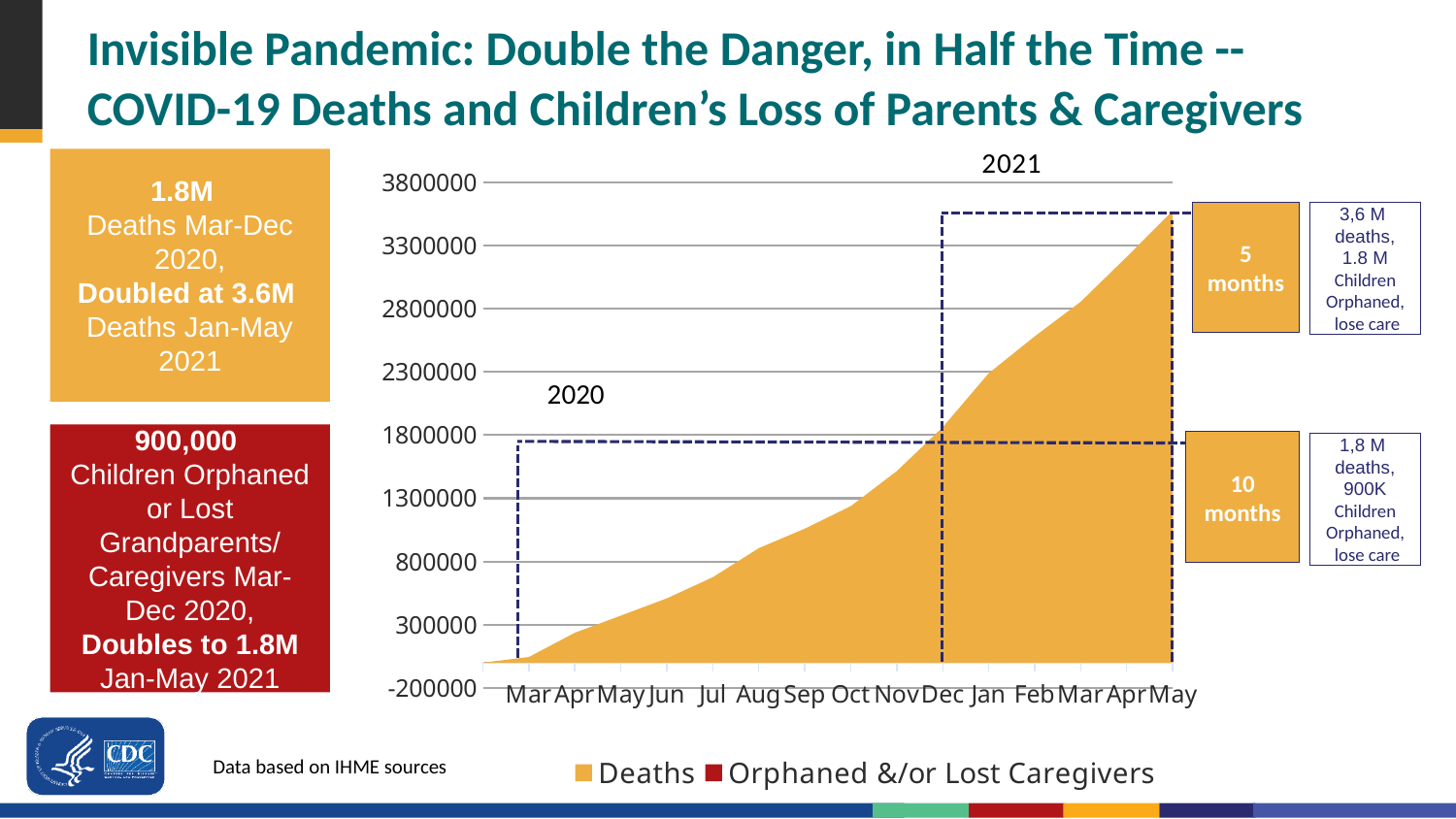
Is the value for Mar 2021 greater or less than 2800000? greater Do the plotted values rise or fall from Mar 2020 to May 2021? Rise Is the value for Sep 2020 greater or less than 800000? greater How many series does the chart legend list? 2 How many months are labelled along the x axis of the chart? 15 Is the value for Nov 2020 greater or less than 1300000? greater What colour represents the Deaths series in the legend? Orange What kind of chart is shown on the slide? Area chart Which month has the highest plotted value on the chart? May 2021 Which month has the lowest plotted value on the chart? Mar 2020